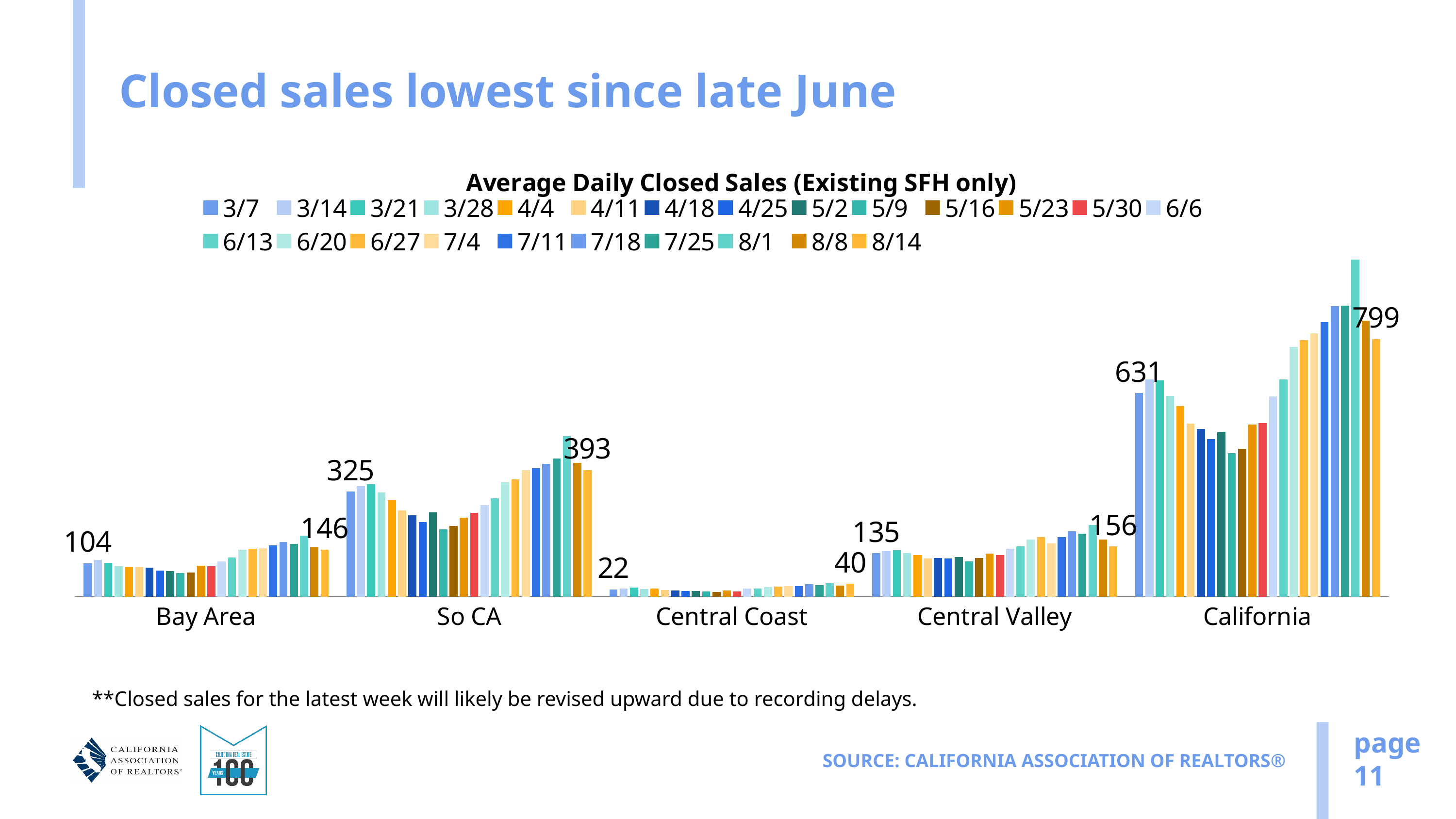
Which region has the lowest average daily closed sales on 8/14? Central Coast What is the average daily closed sales value for Bay Area on 8/14? 146 What is the average daily closed sales value for California on 8/14? 799 What is the difference between California's 8/14 value and its 3/7 value? 168 How many regions (categories) are shown on the x axis? 5 What is the title of the chart? Average Daily Closed Sales (Existing SFH only) What is the average daily closed sales value for So CA on 3/7? 325 What is the average daily closed sales value for Central Valley on 8/14? 156 What kind of chart is shown on the slide? bar chart How many series does the legend list? 24 What is the average daily closed sales value for Bay Area on 3/7? 104 What is the difference between So CA's 8/14 value and its 3/7 value? 68